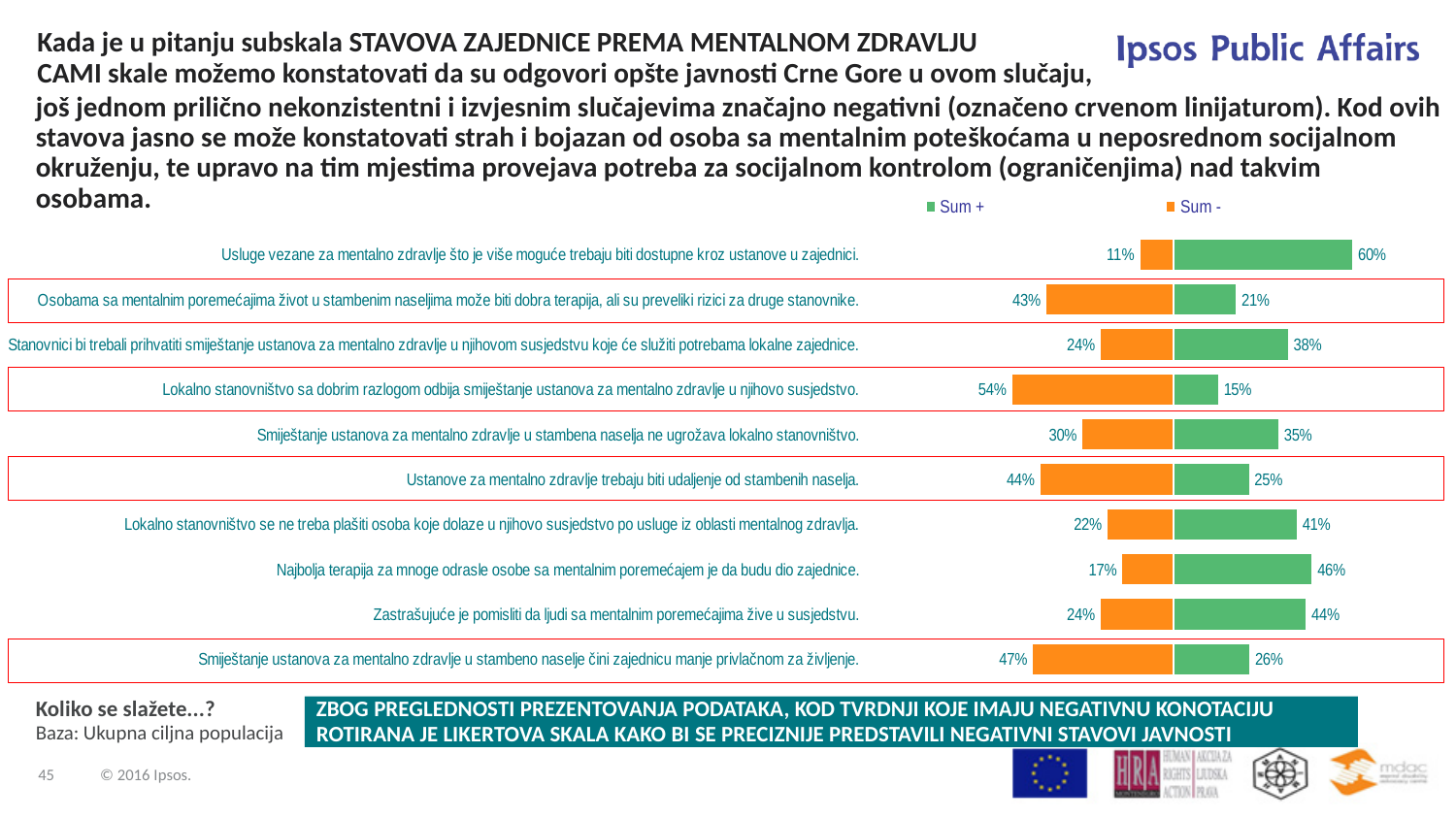
What type of chart is shown on the slide? Bar chart Which statement has the lowest Sum + value? Lokalno stanovništvo sa dobrim razlogom odbija smještanje ustanova za mentalno zdravlje u njihovo susjedstvo. What is the Sum - value for the statement "Lokalno stanovništvo sa dobrim razlogom odbija smještanje ustanova za mentalno zdravlje u njihovo susjedstvo."? 54% For the statement "Najbolja terapija za mnoge odrasle osobe sa mentalnim poremećajem je da budu dio zajednice.", how much larger is the Sum + value than the Sum - value? 29 percentage points What is the Sum + value for the statement "Usluge vezane za mentalno zdravlje što je više moguće trebaju biti dostupne kroz ustanove u zajednici."? 60% What is the Sum + value for the statement "Zastrašujuće je pomisliti da ljudi sa mentalnim poremećajima žive u susjedstvu."? 44% Which statement has the highest Sum + value? Usluge vezane za mentalno zdravlje što je više moguće trebaju biti dostupne kroz ustanove u zajednici. For the statement "Smještanje ustanova za mentalno zdravlje u stambena naselja ne ugrožava lokalno stanovništvo.", which is larger, Sum + or Sum -? Sum + Which statement has the highest Sum - value? Lokalno stanovništvo sa dobrim razlogom odbija smještanje ustanova za mentalno zdravlje u njihovo susjedstvo. Which statement has the lowest Sum - value? Usluge vezane za mentalno zdravlje što je više moguće trebaju biti dostupne kroz ustanove u zajednici. How many statements are shown in the chart? 10 How many series does the chart legend list? 2